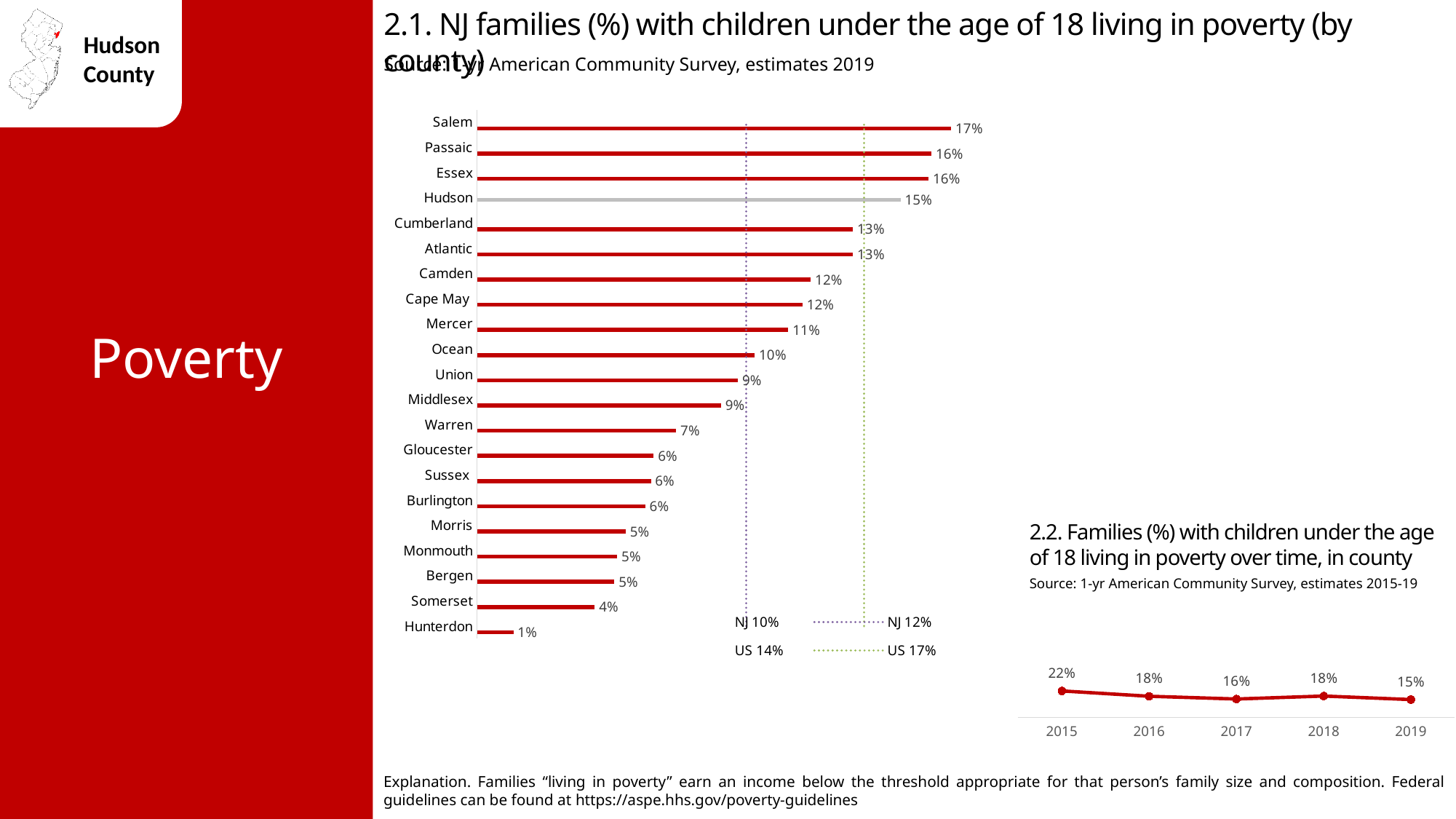
In chart 2.2 (poverty over time, in county), do the values generally rise or fall from 2015 to 2019? Fall In chart 2.1 (by county), what is the value for Somerset? 4% In chart 2.1 (by county), how many counties are plotted? 21 In chart 2.1 (by county), which county has the highest value? Salem What kind of chart is chart 2.1 (by county)? Bar chart In chart 2.2 (poverty over time, in county), what is the difference between the values for 2015 and 2019? 7% In chart 2.1 (NJ families with children under 18 living in poverty by county), what is the value for Hudson? 15% In chart 2.1 (by county), which county has the lowest value? Hunterdon In chart 2.2 (poverty over time, in county), what is the value for 2015? 22% In chart 2.1 (by county), what is the difference between the values for Salem and Hudson? 2% In chart 2.1 (by county), which is larger, the value for Mercer or the value for Warren? Mercer